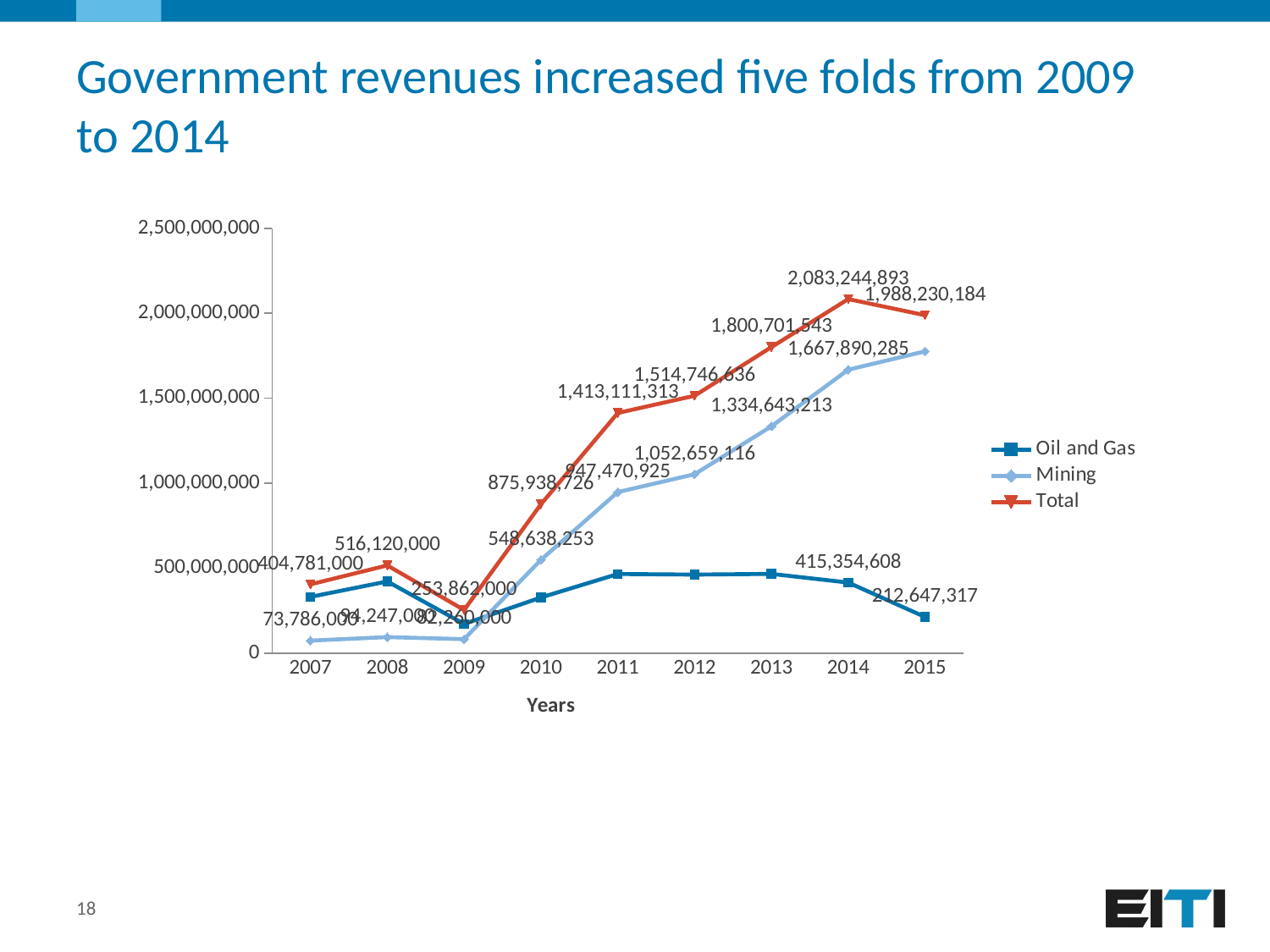
What is the title of the x axis? Years How many years are plotted along the x axis? 9 By how much did the Total fall from 2014 to 2015? 95,014,709 What is the Total value for 2015? 1,988,230,184 How many series does the legend list? 3 What is the Mining value for 2014? 1,667,890,285 Is the Oil and Gas value for 2011 greater or less than 500,000,000? less In which year is the Total series lowest? 2009 What kind of chart is shown on the slide? Line chart In which year is the Total series highest? 2014 What is the Total value for 2014? 2,083,244,893